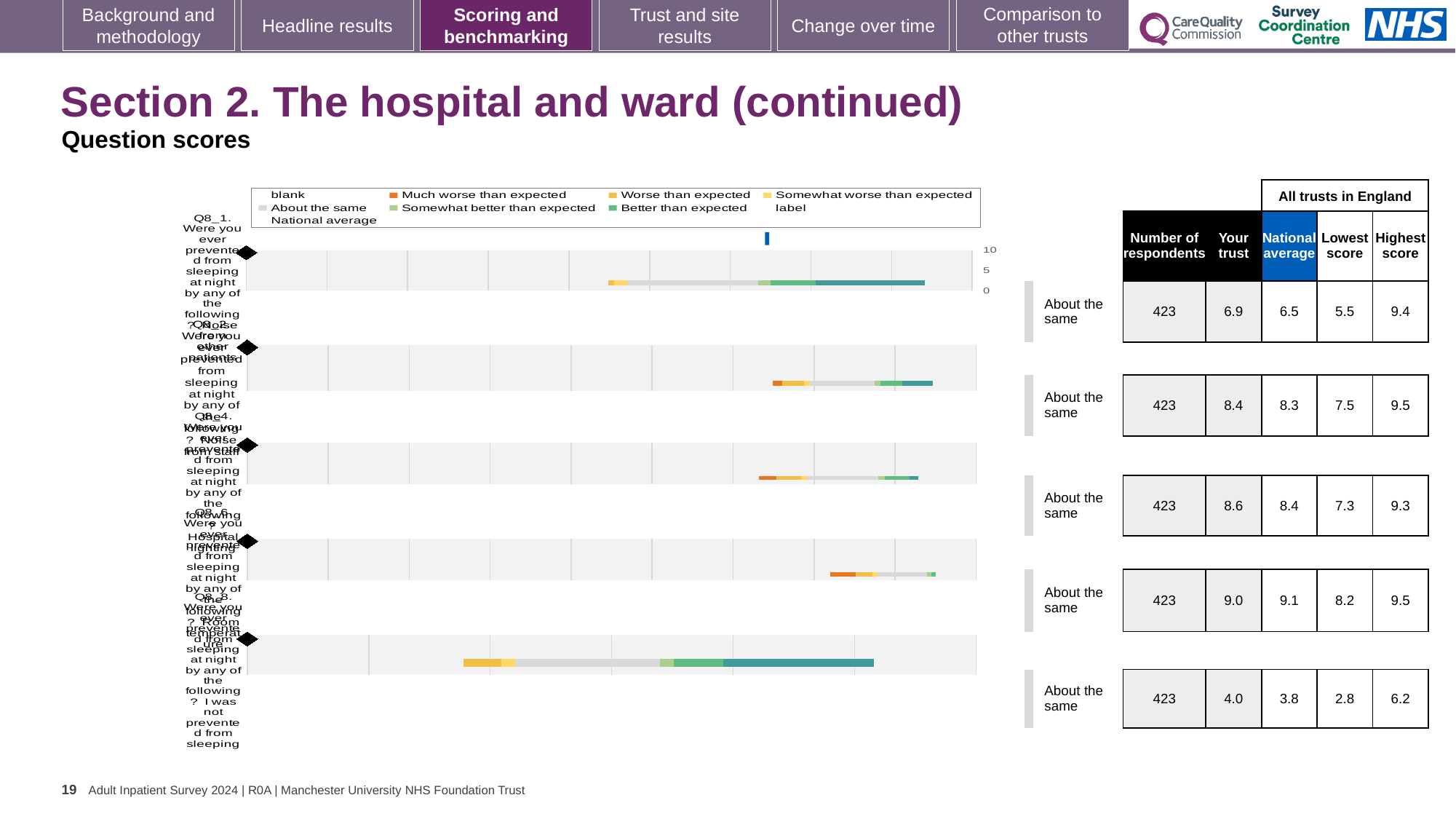
What benchmark label is shown next to every row of the chart? About the same How many question rows (bars) does the chart show? 5 What is the highest score among all trusts in England for the third row of the chart? 9.3 Which row of the chart has the highest 'Your trust' score? the fourth row (9.0) What is the 'Your trust' score for the first (top) row of the chart? 6.9 For the fourth row of the chart, which is larger: the 'Your trust' score or the national average? National average Which row of the chart has the lowest 'Your trust' score? the fifth (bottom) row (4.0) What is the lowest score among all trusts in England for the fifth (bottom) row of the chart? 2.8 What is the national average for the first (top) row of the chart? 6.5 What is the number of respondents shown for the second row of the chart? 423 What kind of chart is shown on the slide? bar chart What is the difference between the highest 'Your trust' score (9.0) and the lowest 'Your trust' score (4.0) in the chart? 5.0